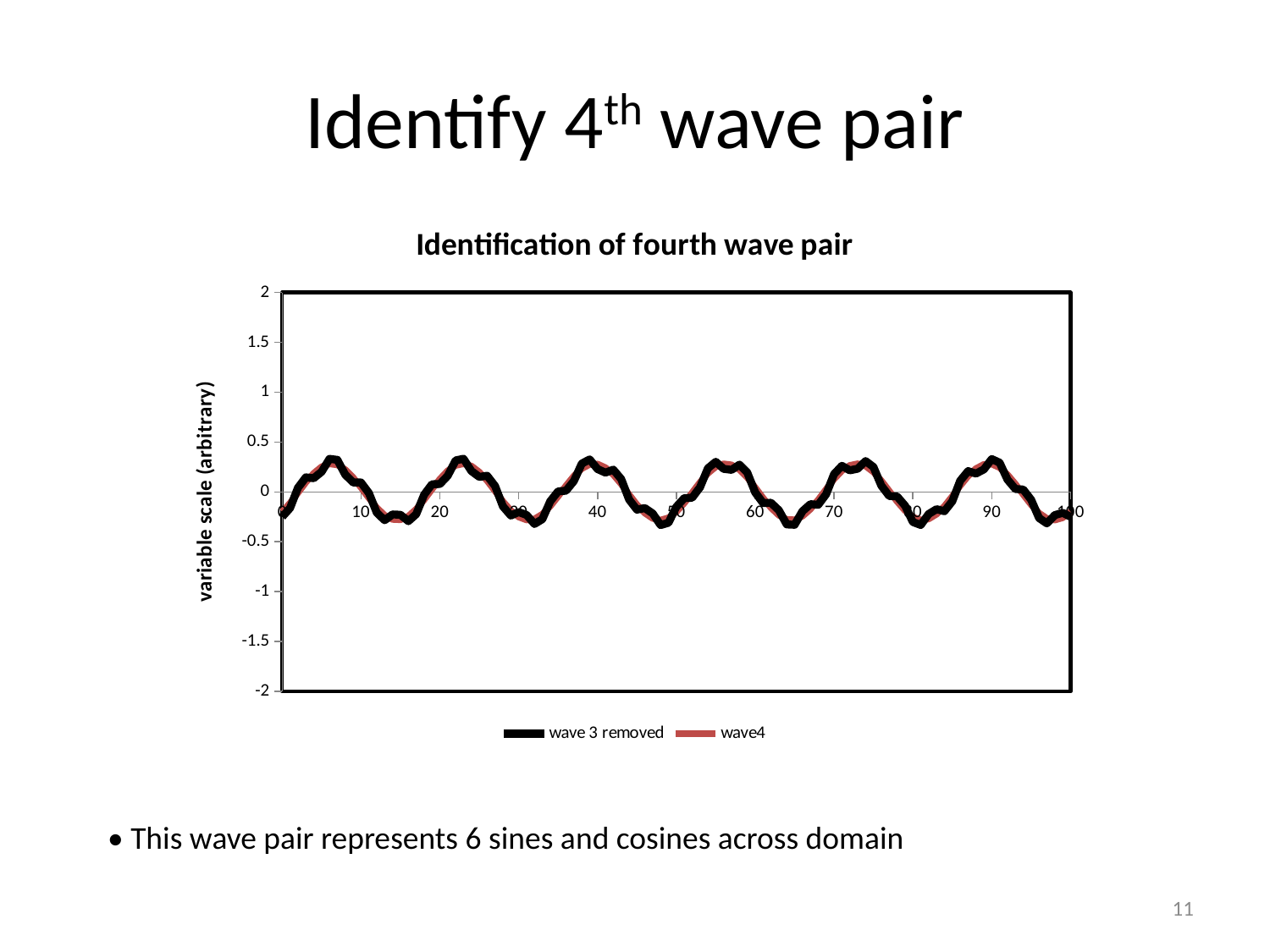
Is the lowest value reached by the "wave 3 removed" series greater or less than -0.5? greater Is the value of the "wave 3 removed" series at x = 40 greater or less than 0? greater What are the two series named in the legend? wave 3 removed and wave4 How many peaks does the wave show across the x-axis domain from 0 to 100? 6 What is the title of the chart? Identification of fourth wave pair Is the highest value reached by the "wave 3 removed" series greater or less than 0.5? less How many series does the legend list? 2 What kind of chart is shown on the slide? line chart